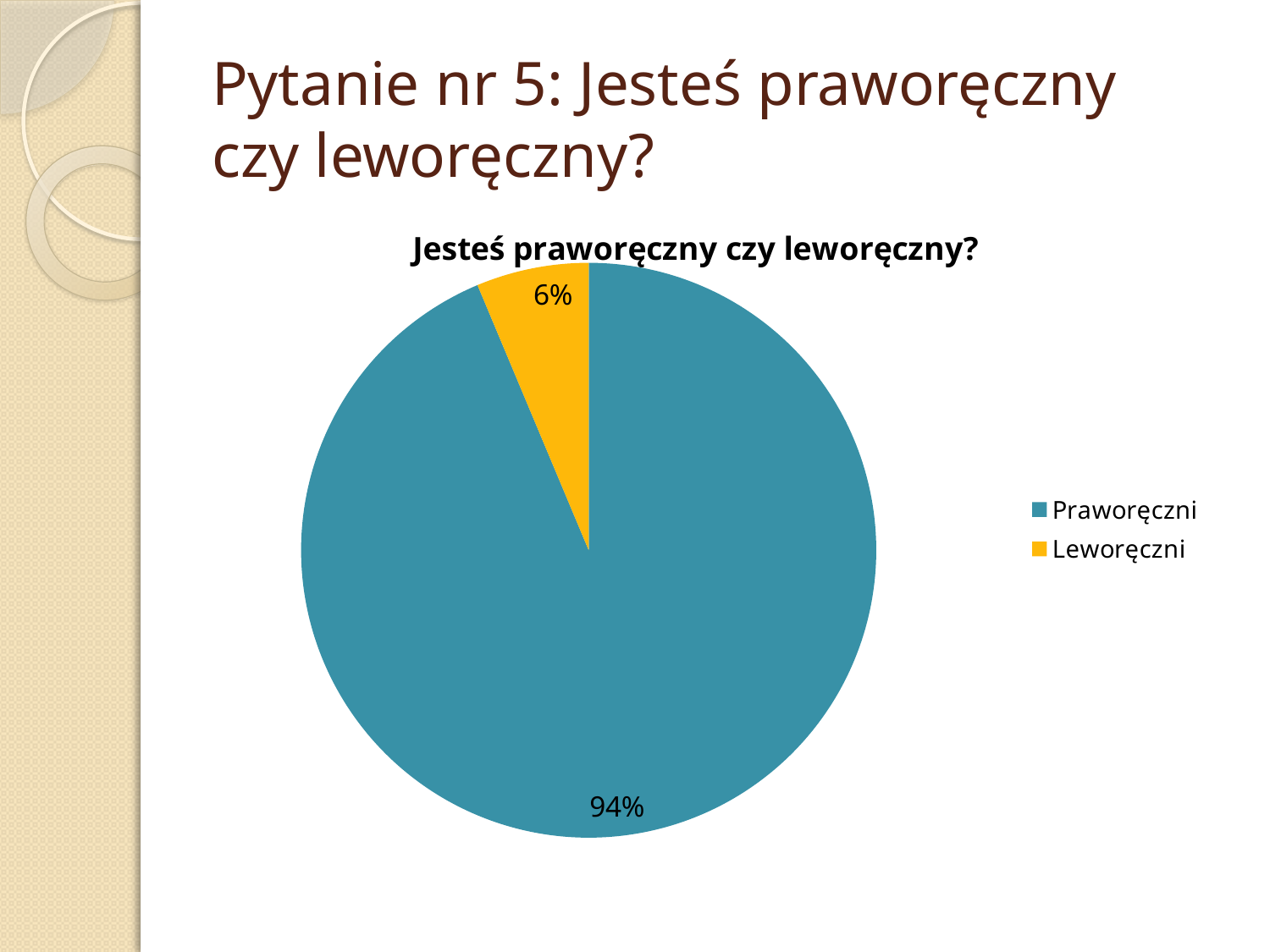
What kind of chart is shown on the slide? Pie chart Which category has the smallest slice of the pie? Leworęczni What share of the pie does Leworęczni take? 6% How many entries does the legend list? 2 Which is larger, the slice for Praworęczni or the slice for Leworęczni? Praworęczni What is the title of the chart? Jesteś praworęczny czy leworęczny? What colour is the slice for Leworęczni? Yellow How many slices does the pie chart have? 2 Which category has the largest slice of the pie? Praworęczni What share of the pie does Praworęczni take? 94% What is the difference in percentage points between Praworęczni and Leworęczni? 88